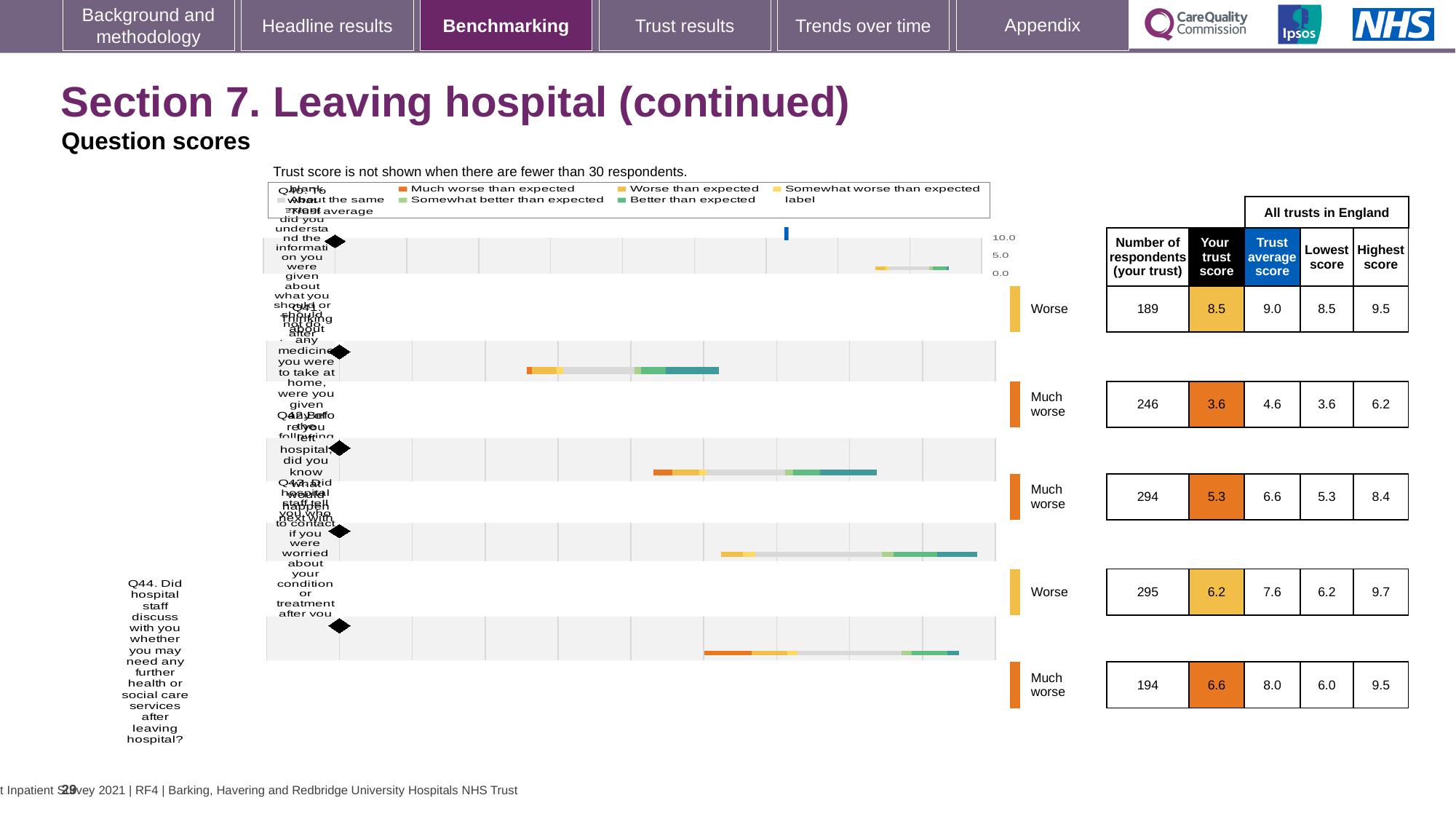
In the table next to the chart, what is the difference between the trust average score and the trust score in the bottom row (Q44)? 1.4 How many chart rows are labelled 'Much worse'? 3 In the table next to the chart, which row has the highest number of respondents? the fourth row (295) How many question rows are plotted in the chart? 5 In the table next to the chart, what is the number of respondents in the first row? 189 In the table next to the chart, what is the highest score for the bottom row (Q44)? 9.5 What colour represents 'Better than expected' in the legend? teal In the table next to the chart, what is the trust score for the bottom row (Q44)? 6.6 In the table next to the chart, what is the trust average score for the bottom row (Q44)? 8.0 What colour represents 'Much worse than expected' in the legend? orange What kind of chart is shown on the slide? bar chart In the table next to the chart, what is the number of respondents for the bottom row (Q44)? 194